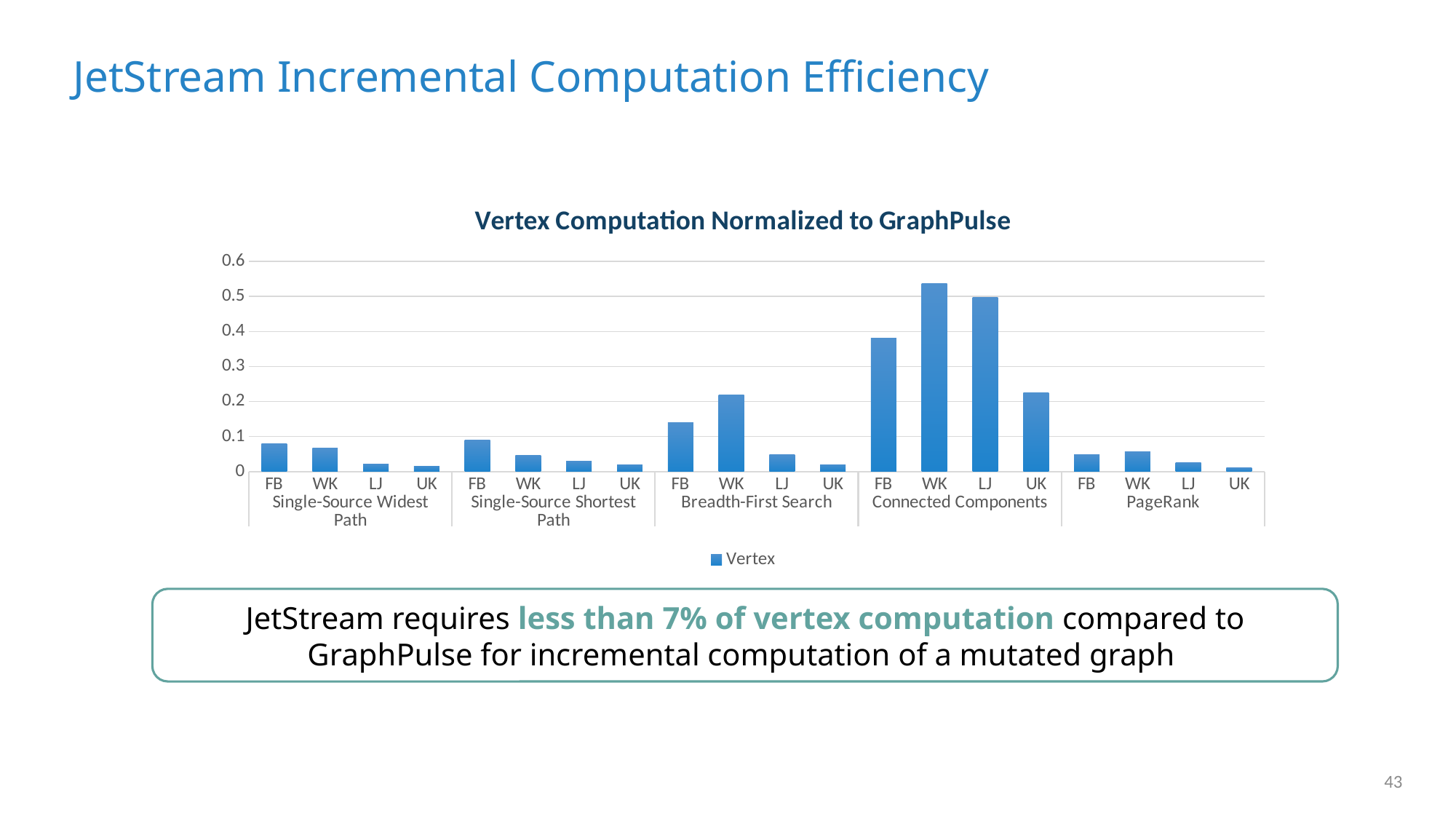
Which is larger: the value for FB under Breadth-First Search or the value for WK under Breadth-First Search? WK under Breadth-First Search Is the value for FB under Single-Source Widest Path greater or less than 0.1? less How many algorithm groups are shown along the x axis? 5 Is the value for WK under Connected Components greater or less than 0.5? greater Is the value for FB under Connected Components greater or less than 0.4? less Which is larger: the value for UK under Connected Components or the value for UK under PageRank? UK under Connected Components What is the title of the chart? Vertex Computation Normalized to GraphPulse Which bar is the highest on the chart? WK under Connected Components How many series does the legend list? 1 What type of chart is shown on the slide? bar chart How many bars are plotted in total on the chart? 20